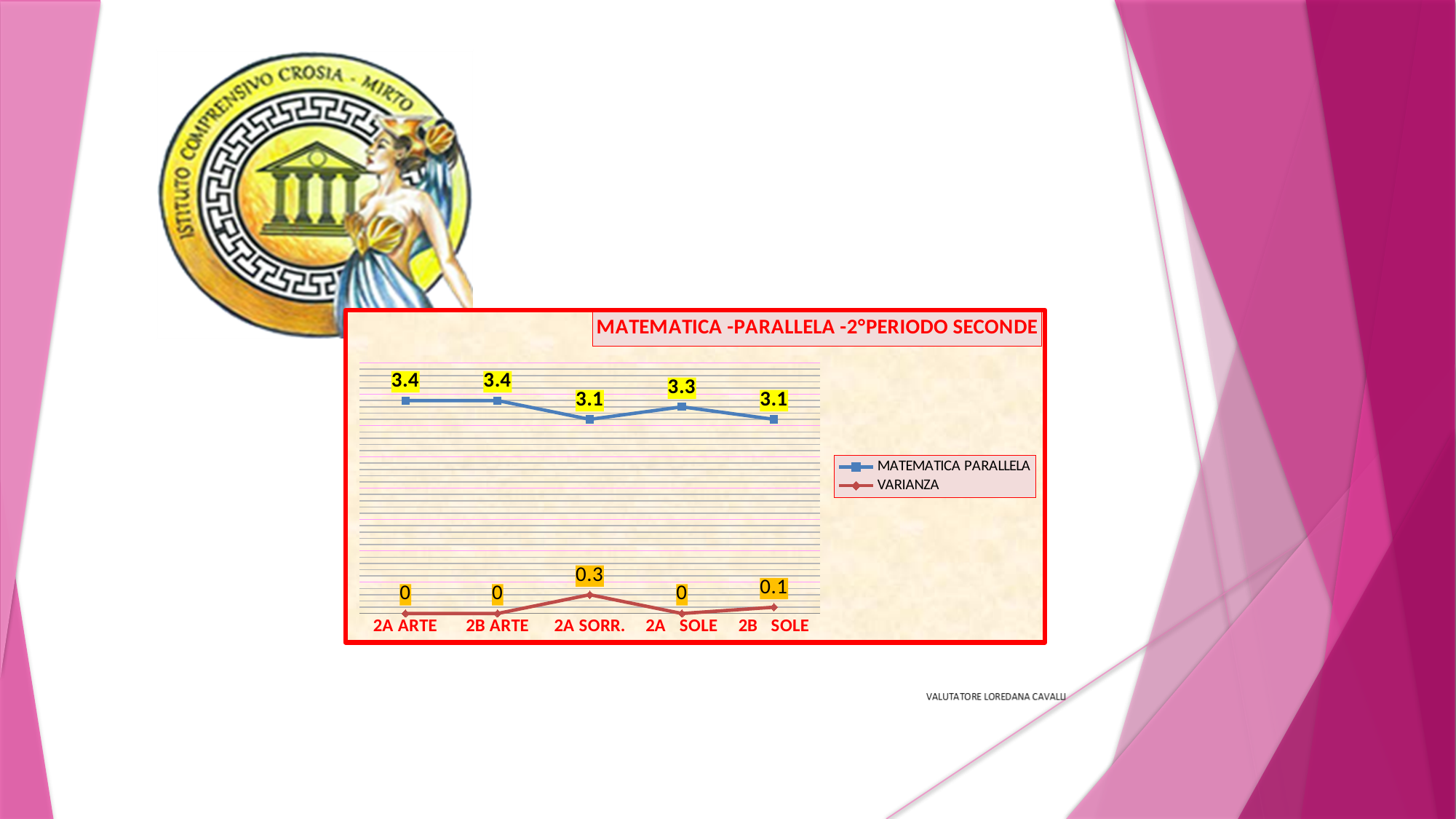
What is the MATEMATICA PARALLELA value for 2A ARTE? 3.4 How many series does the legend list? 2 Which category has the highest MATEMATICA PARALLELA value? 2A ARTE and 2B ARTE Which category has the highest VARIANZA value? 2A SORR. What is the difference between the MATEMATICA PARALLELA values for 2B ARTE and 2A SORR.? 0.3 What kind of chart is this? Line chart What is the VARIANZA value for 2A SORR.? 0.3 Which is larger, the MATEMATICA PARALLELA value for 2A SOLE or for 2B SOLE? 2A SOLE What is the VARIANZA value for 2B SOLE? 0.1 What is the MATEMATICA PARALLELA value for 2A SOLE? 3.3 How many categories are shown on the x axis? 5 What is the title of the chart? MATEMATICA -PARALLELA -2°PERIODO SECONDE